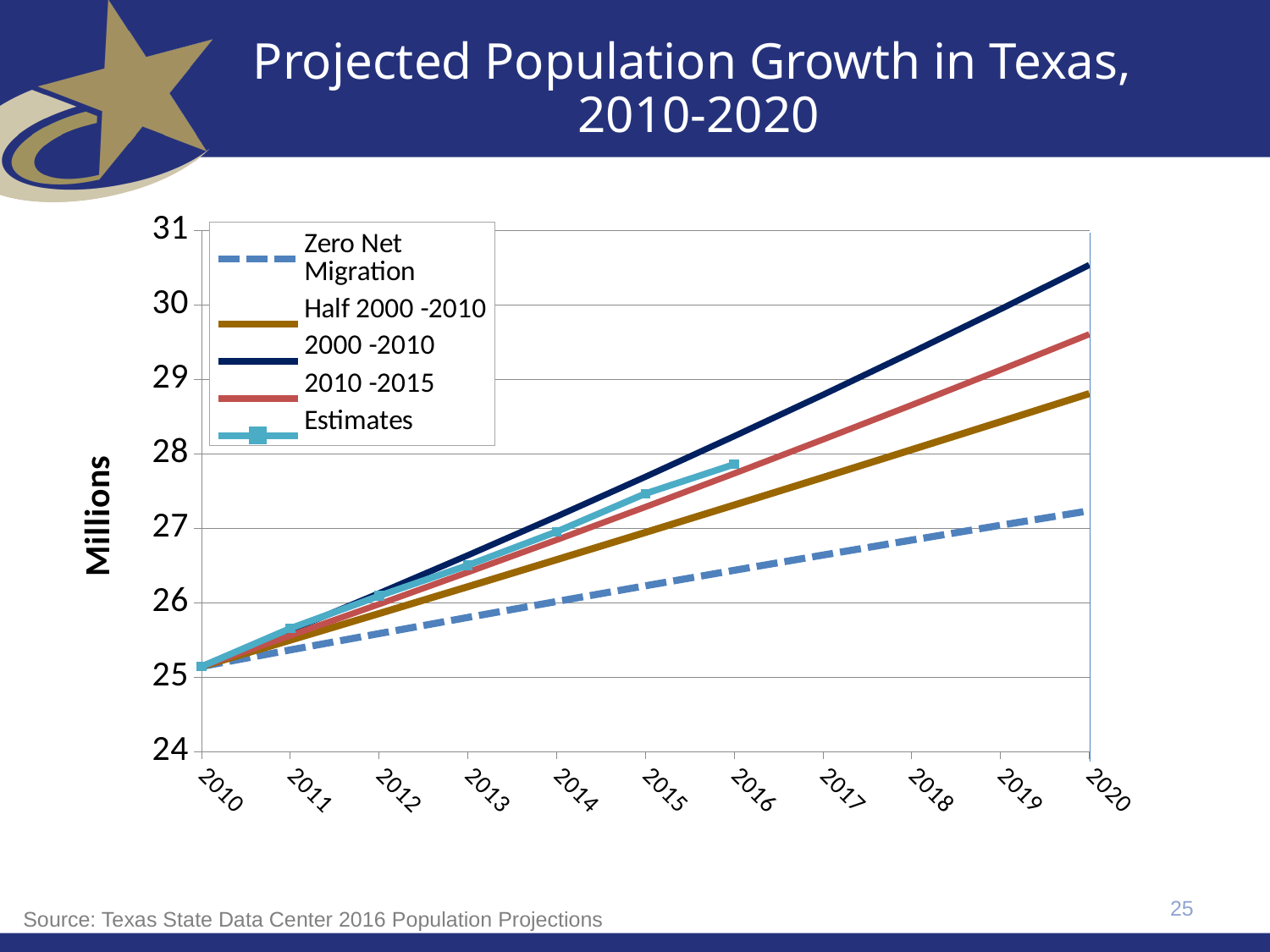
Is the value for the 2000 -2010 series in 2020 greater or less than 30? greater What kind of chart is shown on the slide? line chart Is the value for the Zero Net Migration series in 2020 greater or less than 28? less Which series has the lowest value in 2020? Zero Net Migration How many years are shown along the x axis? 11 Do the values of the 2000 -2010 series rise or fall from 2010 to 2020? rise Is the value for the 2010 -2015 series in 2020 greater or less than 29? greater Which series has the highest value in 2020? 2000 -2010 In 2020, which is larger: the 2010 -2015 series or the Half 2000 -2010 series? 2010 -2015 How many series does the legend list? 5 What is the label on the y axis? Millions